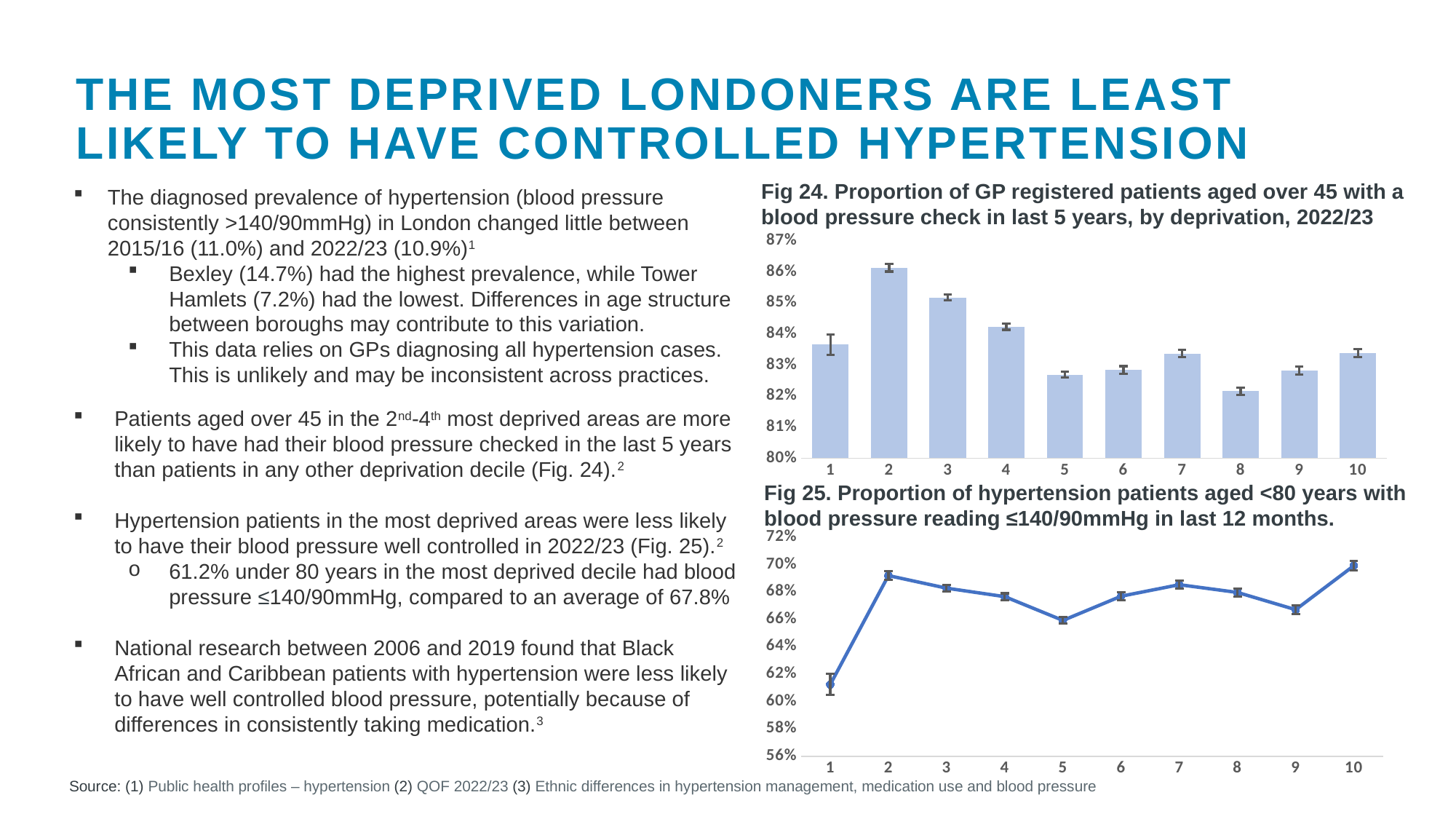
What kind of chart is Fig 25? line chart In Fig 25, which deprivation decile has the lowest proportion of patients with blood pressure ≤140/90mmHg? 1 In Fig 25, is the value for decile 1 greater or less than 62%? less In Fig 24, which is larger, the value for decile 3 or the value for decile 5? decile 3 In Fig 24, which deprivation decile has the lowest proportion of patients with a blood pressure check? 8 In Fig 24, which deprivation decile has the highest proportion of patients with a blood pressure check? 2 How many deprivation deciles are shown on the x axis of Fig 24? 10 In Fig 25, which is larger, the value for decile 1 or the value for decile 2? decile 2 In Fig 24, is the value for decile 8 greater or less than 83%? less What kind of chart is Fig 24? bar chart In Fig 24, is the value for decile 2 greater or less than 85%? greater